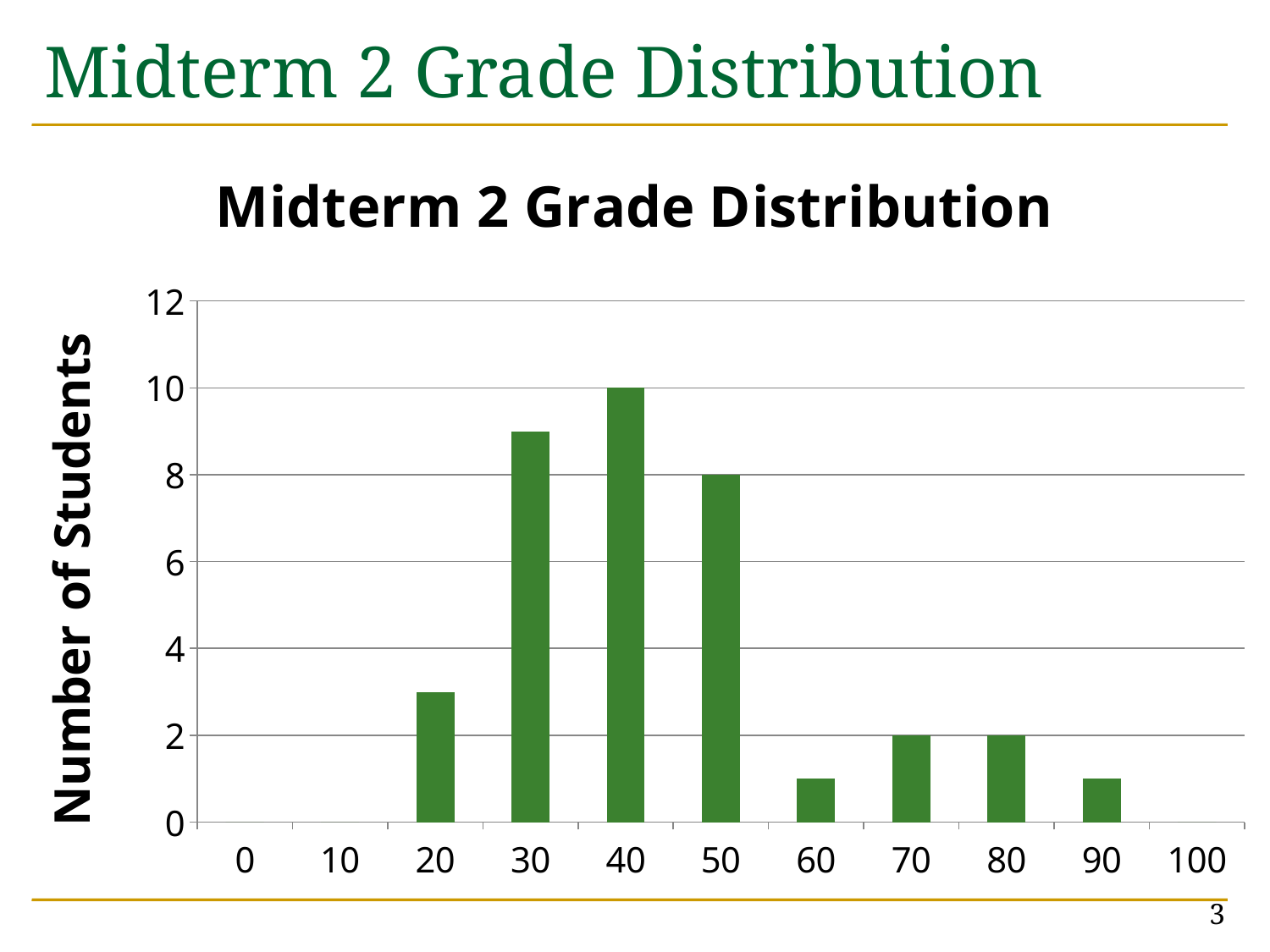
What is the number of students for the 70 category? 2 How many students scored 40 on Midterm 2? 10 What is the label of the vertical axis? Number of Students What type of chart is shown on the slide? bar chart Is the number of students for the 30 category greater or less than 8? greater Is the number of students for the 20 category greater or less than 4? less What is the difference in number of students between the 40 and 50 categories? 2 What is the number of students for the 50 category? 8 Is the number of students for the 60 category greater or less than 2? less Which grade category has the highest number of students? 40 Which has more students, the 30 category or the 50 category? 30 How many grade categories are labeled on the x axis? 11